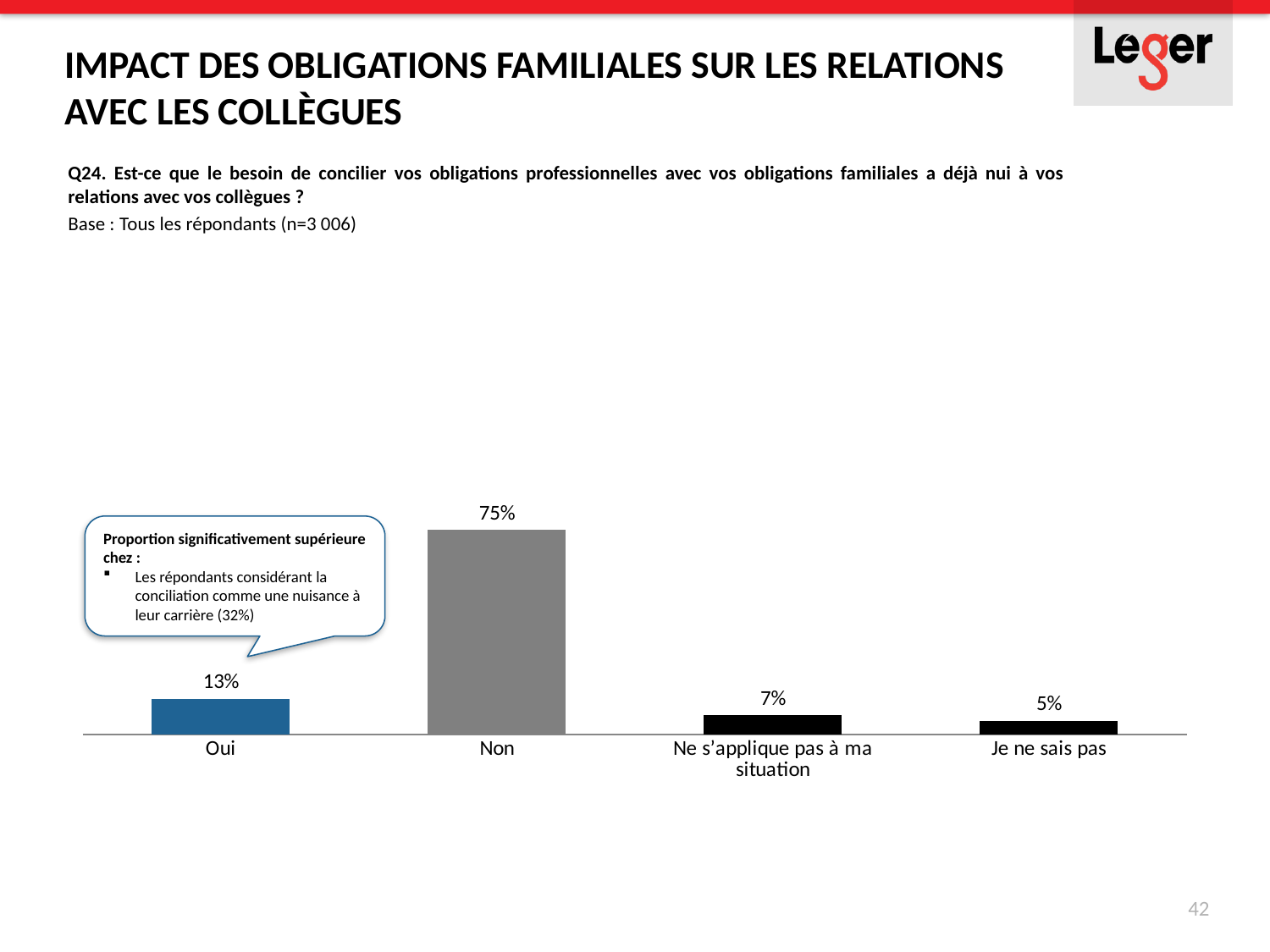
Which is larger, the value for "Oui" or the value for "Ne s'applique pas à ma situation"? Oui Which category has the lowest value? Je ne sais pas Which category has the highest value? Non What is the difference between the values for "Non" and "Oui"? 62% What is the difference between the values for "Ne s'applique pas à ma situation" and "Je ne sais pas"? 2% What is the value for "Ne s'applique pas à ma situation"? 7% What kind of chart is shown on the slide? Bar chart How many categories are shown in the chart? 4 What is the value for "Oui"? 13% What is the value for "Je ne sais pas"? 5% What is the value for "Non"? 75% What colour is the bar for "Oui"? Blue